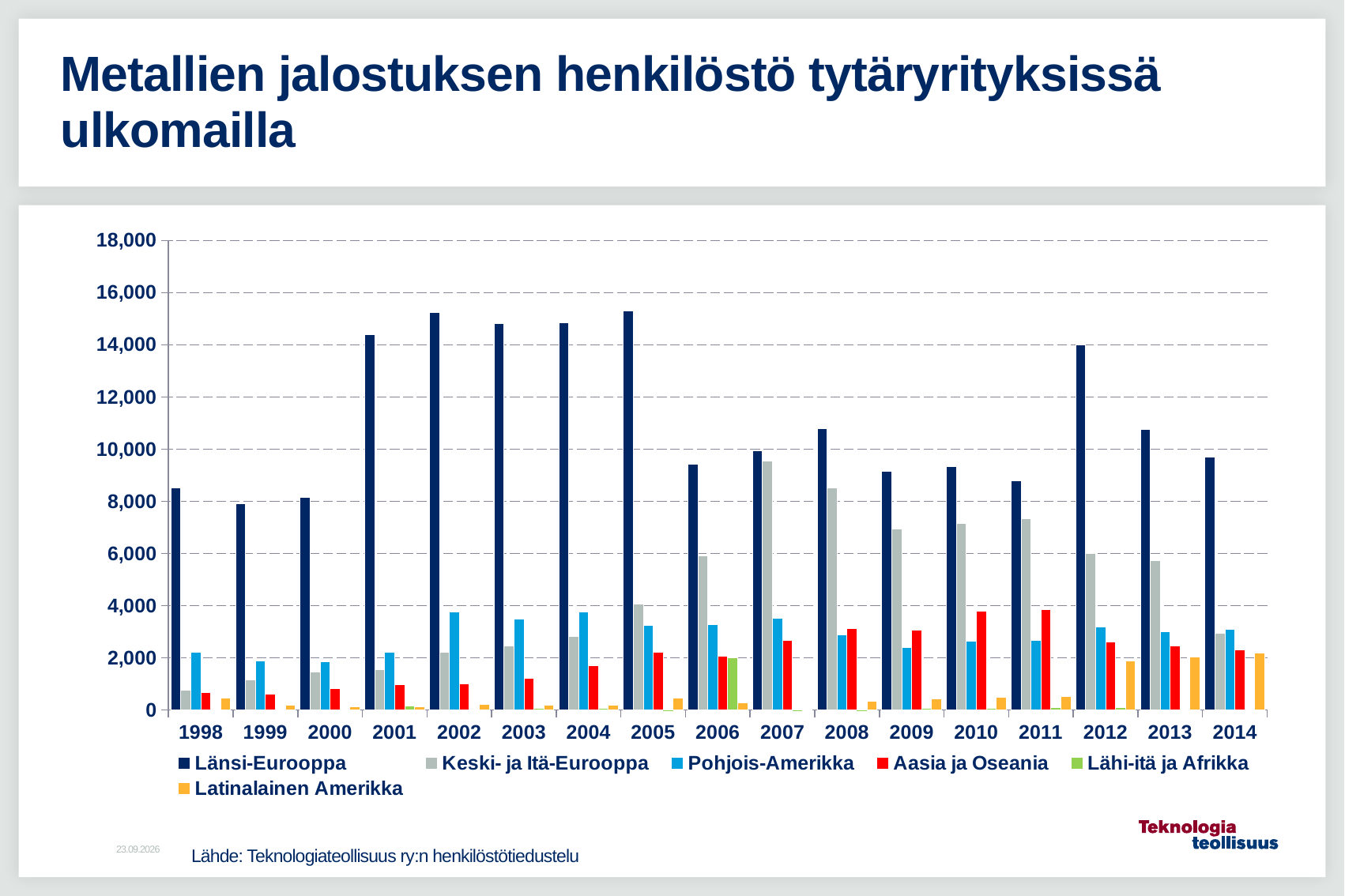
In which year is the value for Keski- ja Itä-Eurooppa highest? 2007 What colour represents Aasia ja Oseania in the legend? red Which is larger: the value for Länsi-Eurooppa in 2001 or in 1998? 2001 Is the value for Keski- ja Itä-Eurooppa in 2007 greater or less than 8,000? greater Does the value for Keski- ja Itä-Eurooppa rise or fall from 1998 to 2007? rise What kind of chart is shown on the slide? bar chart How many series does the legend list? 6 How many years are shown on the x axis? 17 Is the value for Länsi-Eurooppa in 2008 greater or less than 10,000? greater In which year is the value for Keski- ja Itä-Eurooppa lowest? 1998 Is the value for Länsi-Eurooppa in 2002 greater or less than 14,000? greater